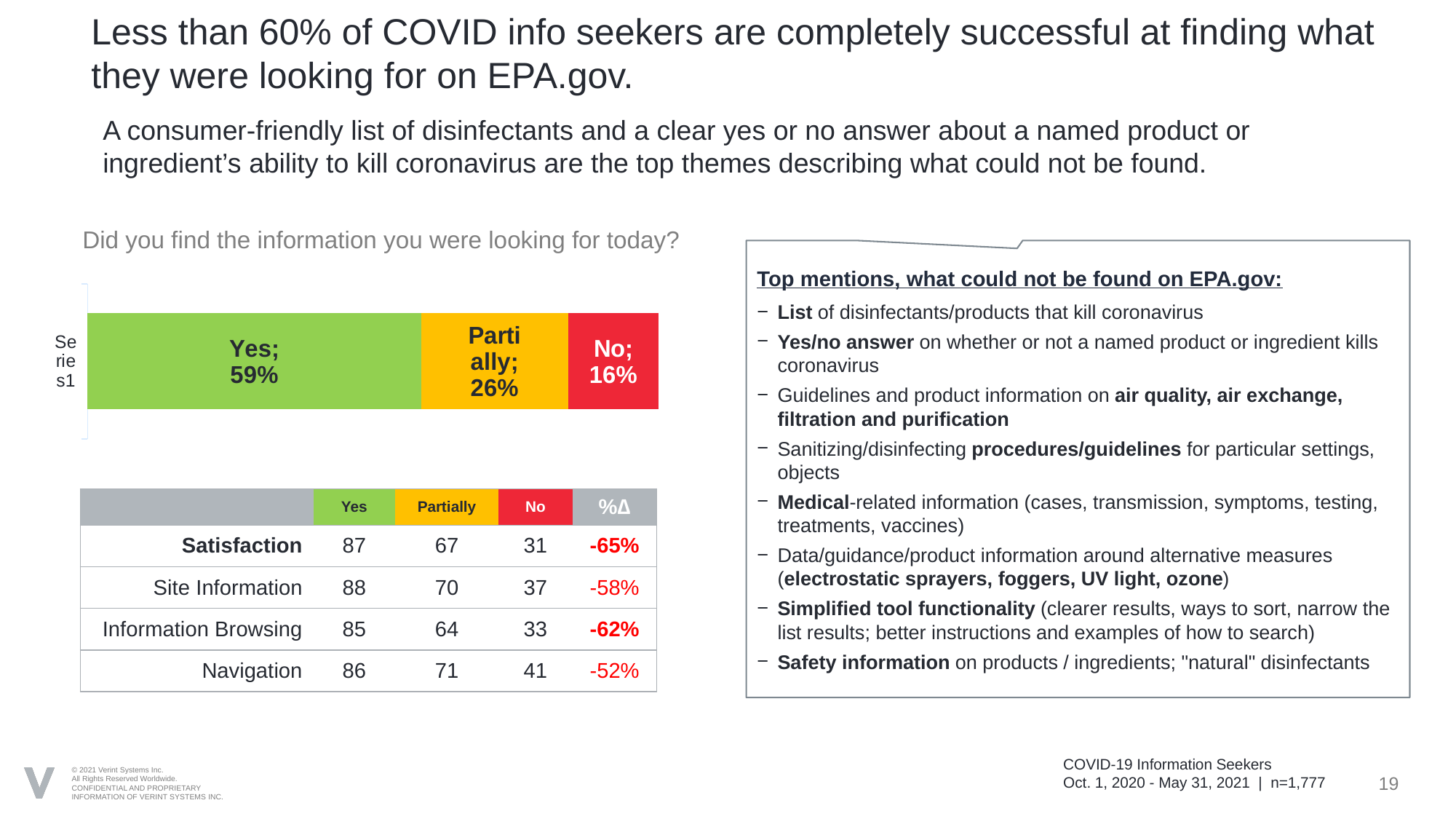
What is the difference in percentage points between the "Yes" and "Partially" segments? 33% Which response category has the largest share in the stacked bar? Yes What percentage of respondents answered "No" in the chart? 16% What is the difference in percentage points between the "Yes" and "No" segments? 43% What type of chart is used to show the responses to "Did you find the information you were looking for today?" Stacked bar chart What question is shown as the title of the chart? Did you find the information you were looking for today? Which response category has the smallest share in the stacked bar? No What colour is the "Yes" segment of the bar? Green Which segment is larger, "Partially" or "No"? Partially What percentage of respondents answered "Partially" in the chart? 26% What percentage of respondents answered "Yes" in the chart "Did you find the information you were looking for today?" 59% How many response segments make up the stacked bar? 3